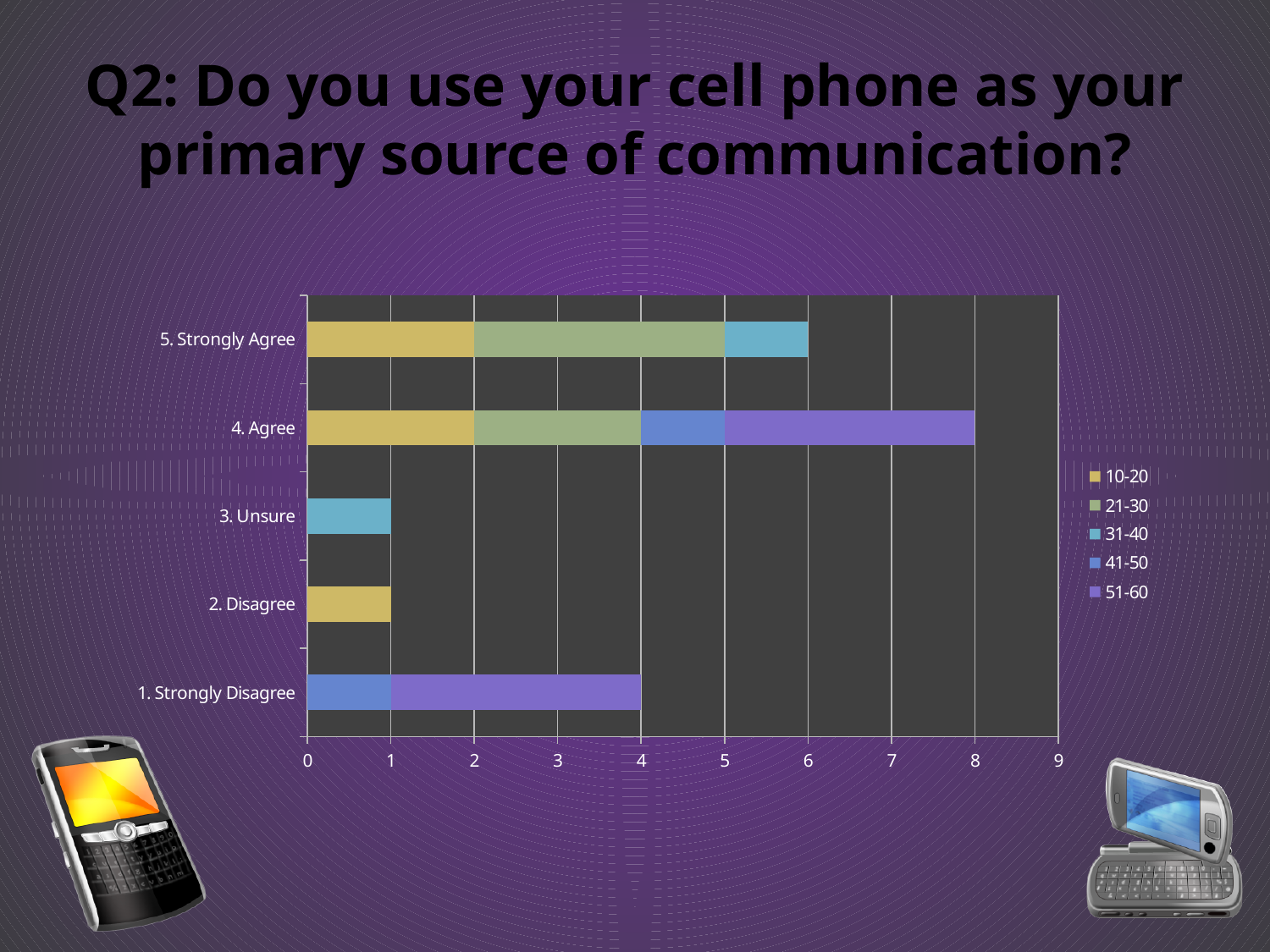
What is the value of the 10-20 series for 5. Strongly Agree? 2 What is the total length of the bar for 5. Strongly Agree? 6 What is the value for 3. Unsure? 1 Which is larger in total, the bar for 5. Strongly Agree or the bar for 1. Strongly Disagree? 5. Strongly Agree What is the difference between the total for 4. Agree and the total for 5. Strongly Agree? 2 How many response categories are shown on the chart? 5 What is the total length of the bar for 4. Agree? 8 Which legend entry is shown in yellow? 10-20 Which response category has the longest bar overall? 4. Agree What kind of chart is shown on the slide? stacked bar chart How many series does the legend list? 5 What is the total length of the bar for 1. Strongly Disagree? 4